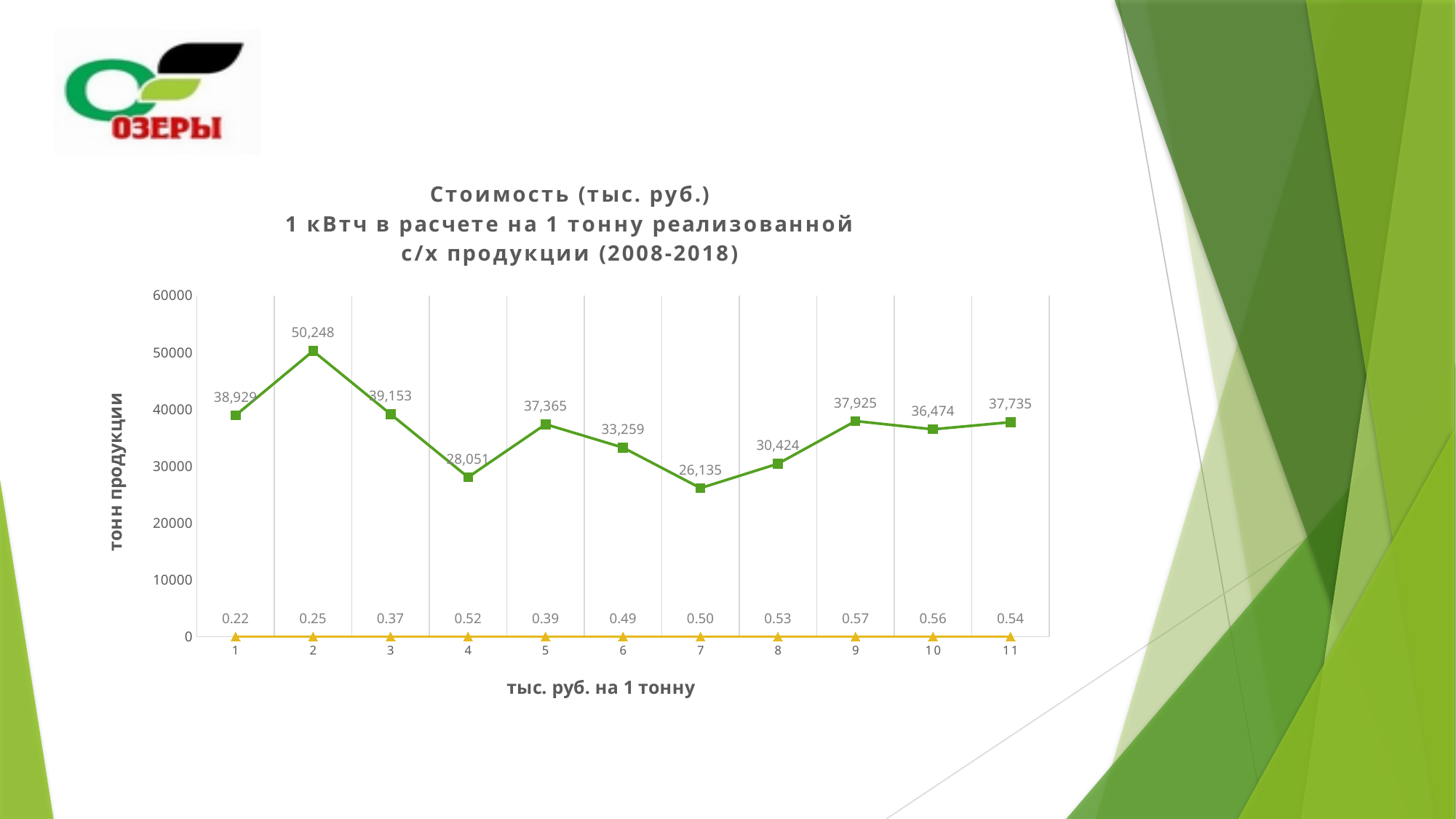
At which point does the green line reach its lowest value? 7 What is the value labelled for the yellow series at point 9? 0.57 At which point does the green line reach its highest value? 2 What is the value of the green line at point 2? 50,248 What is the value of the green line at point 11? 37,735 What is the value of the green line at point 7? 26,135 How many points are plotted along the x axis of the chart? 11 What is the value labelled for the yellow series at point 1? 0.22 What is the difference between the green line values at point 2 and point 7? 24,113 Which is larger on the green line: the value at point 9 or the value at point 10? point 9 What is the label of the vertical axis? тонн продукции What type of chart is shown on the slide? line chart